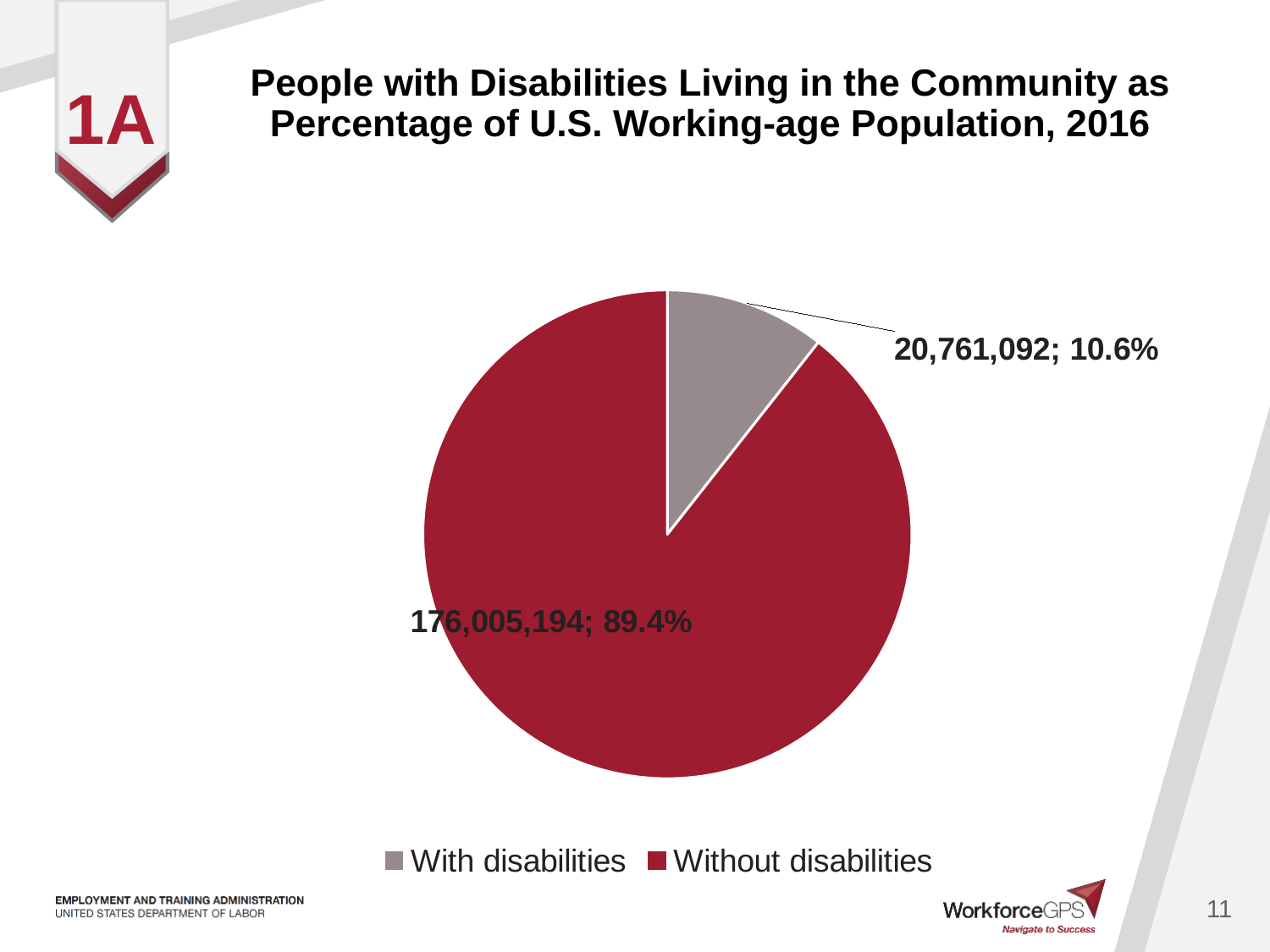
What colour is the 'With disabilities' slice? grey How many slices does the pie chart have? 2 What is the value shown for the 'With disabilities' slice? 20,761,092 What percentage share of the pie is 'With disabilities'? 10.6% Which slice is the largest? Without disabilities Which slice is the smallest? With disabilities What is the difference between the 'Without disabilities' and 'With disabilities' values? 155,244,102 How many entries does the legend list? 2 What kind of chart is shown on the slide? pie chart What is the value shown for the 'Without disabilities' slice? 176,005,194 Which is larger, 'With disabilities' or 'Without disabilities'? Without disabilities What percentage share of the pie is 'Without disabilities'? 89.4%